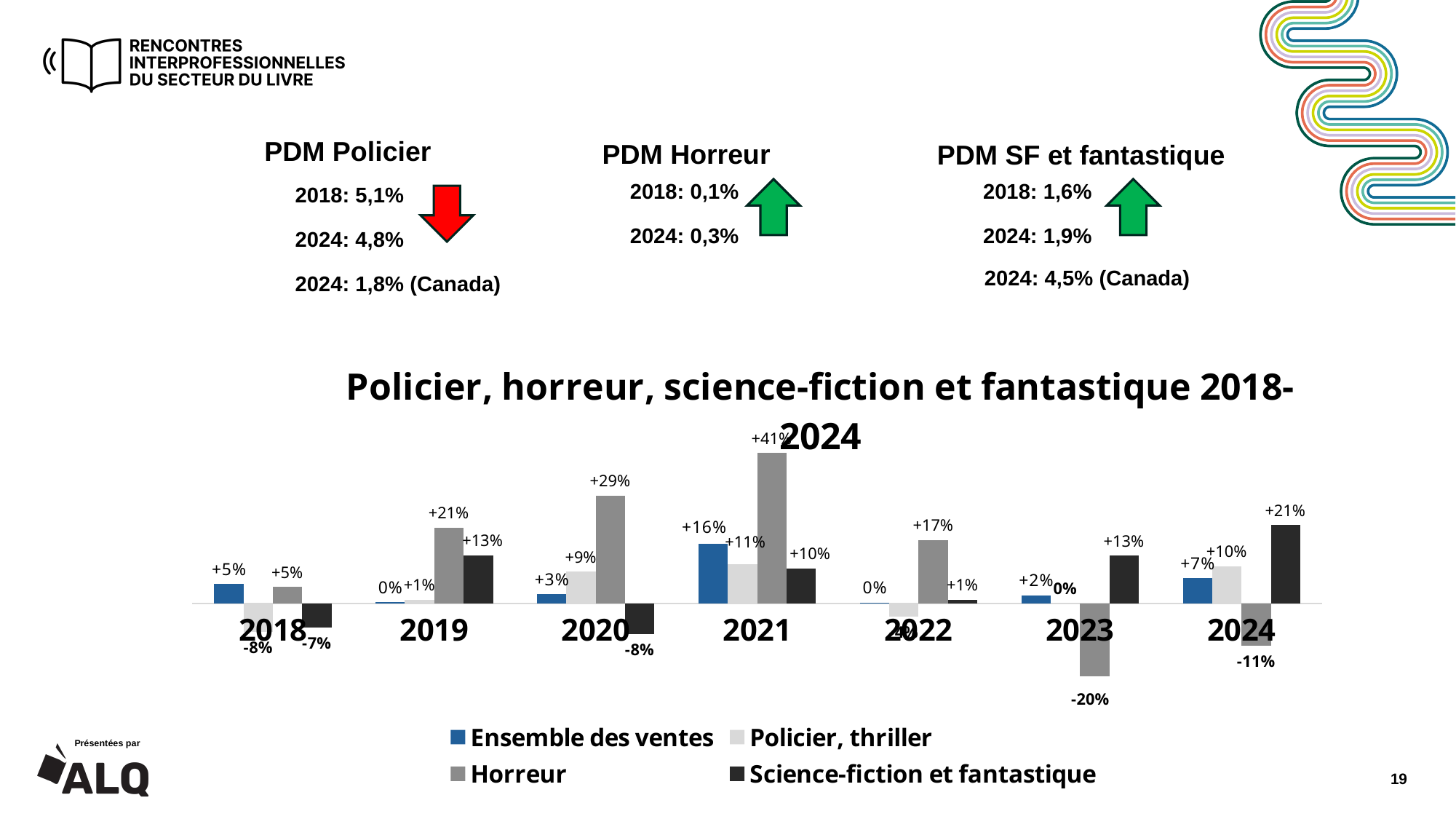
What is the value for Ensemble des ventes in 2021? +16% What is the value for Horreur in 2021? +41% In 2024, which is larger: Science-fiction et fantastique or Policier, thriller? Science-fiction et fantastique What kind of chart is shown on the slide? Bar chart What is the value for Science-fiction et fantastique in 2024? +21% In which year is the Horreur series highest? 2021 In which year is the Horreur series lowest? 2023 How many series does the legend list? 4 What is the difference in percentage points between the Horreur values for 2020 and 2019? 8 percentage points What is the value for Horreur in 2023? -20% What is the title of the chart? Policier, horreur, science-fiction et fantastique 2018-2024 How many years are shown on the x axis? 7